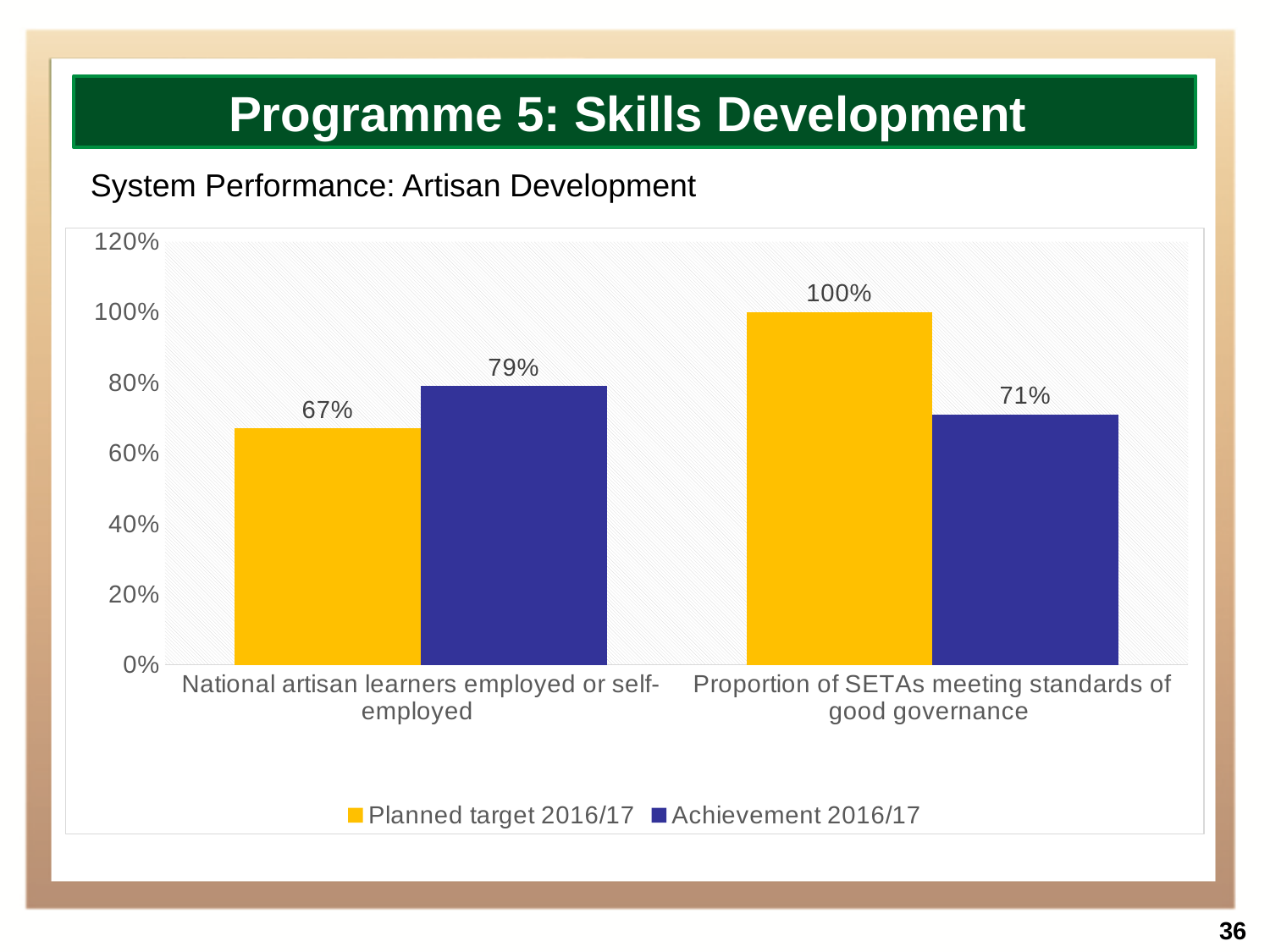
What is the planned target 2016/17 for Proportion of SETAs meeting standards of good governance? 100% Which category has the highest planned target 2016/17? Proportion of SETAs meeting standards of good governance What is the achievement 2016/17 for National artisan learners employed or self-employed? 79% What is the difference between the achievement and the planned target for National artisan learners employed or self-employed? 12% What is the planned target 2016/17 for National artisan learners employed or self-employed? 67% What is the difference between the planned target and the achievement for Proportion of SETAs meeting standards of good governance? 29% What kind of chart is shown on the slide? Bar chart How many categories are shown on the x axis? 2 For National artisan learners employed or self-employed, which is larger: the planned target 2016/17 or the achievement 2016/17? Achievement 2016/17 Which category has the lowest achievement 2016/17? Proportion of SETAs meeting standards of good governance What is the achievement 2016/17 for Proportion of SETAs meeting standards of good governance? 71% How many series does the legend list? 2